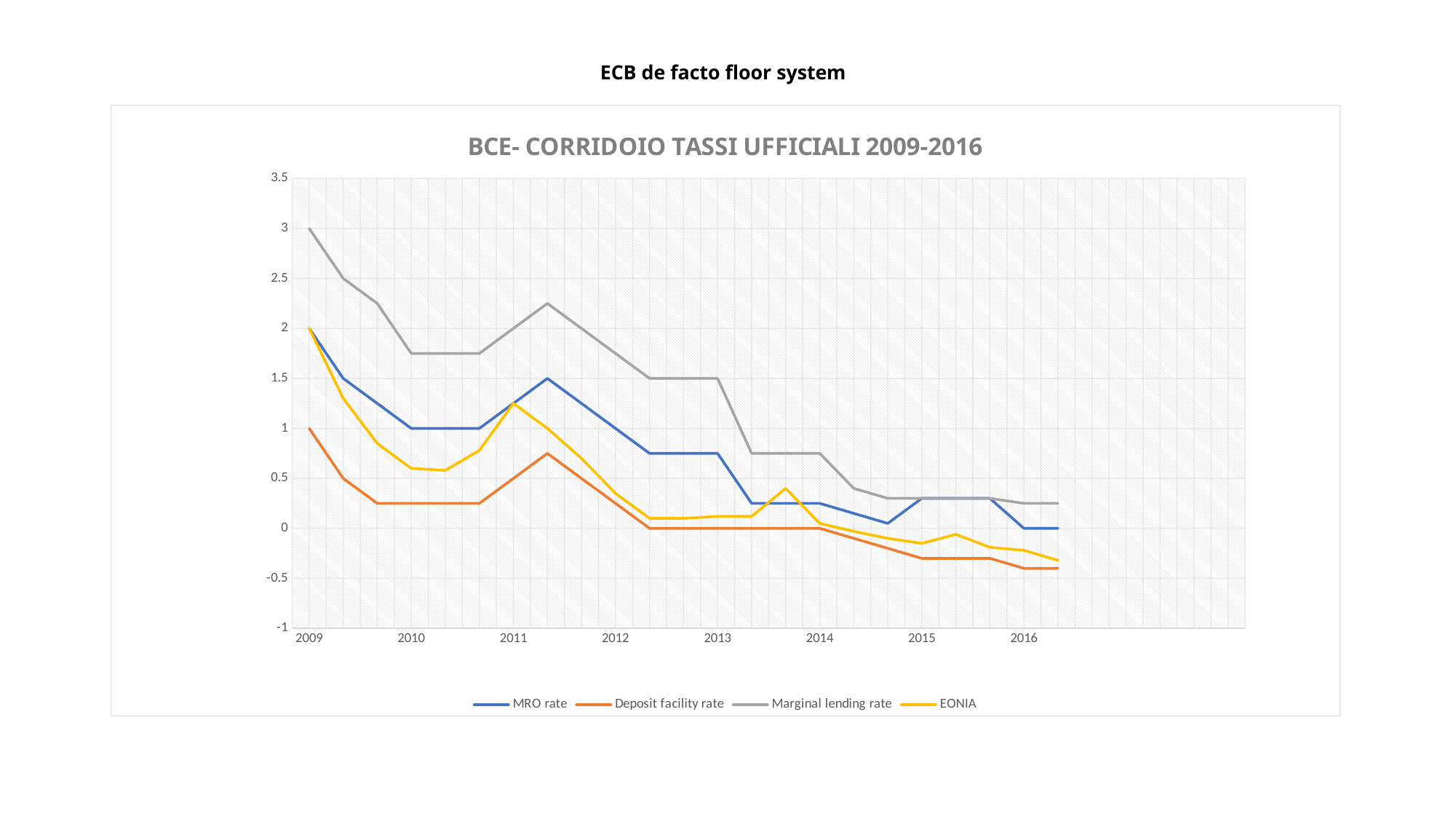
How many series does the legend list? 4 Does the MRO rate generally rise or fall from 2009 to 2016? fall Is the value of EONIA in 2016 greater or less than 0? less What is the MRO rate at the start of 2009? 2 What kind of chart is shown on the slide? line chart What is the Deposit facility rate at the start of 2009? 1 What is the Marginal lending rate at the start of 2009? 3 In 2013, which is larger: the MRO rate or the Deposit facility rate? MRO rate Which series has the highest value in 2009? Marginal lending rate What is the title of the chart? BCE- CORRIDOIO TASSI UFFICIALI 2009-2016 Which series has the lowest value in 2016? Deposit facility rate